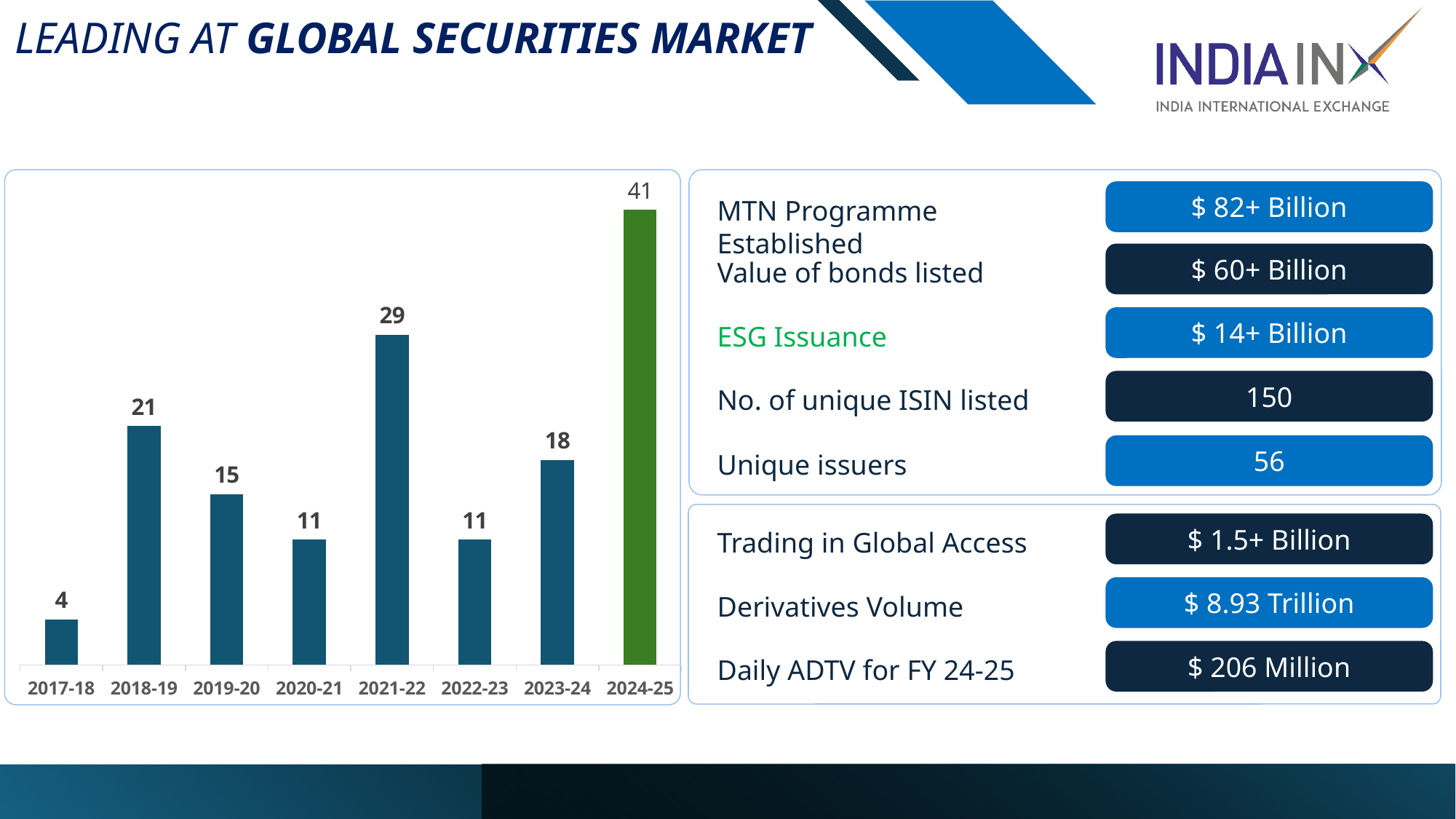
What kind of chart is shown on the slide? bar chart Which two years in the bar chart share the same value of 11? 2020-21 and 2022-23 What is the value for 2017-18 in the bar chart? 4 What is the difference between the values for 2021-22 and 2020-21? 18 Which bar in the chart is coloured green rather than dark blue? 2024-25 Which is larger, the value for 2018-19 or the value for 2019-20? 2018-19 What is the difference between the values for 2024-25 and 2023-24? 23 How many years are shown in the bar chart? 8 What is the value for 2024-25 in the bar chart? 41 What is the value for 2021-22 in the bar chart? 29 Which year has the lowest value in the bar chart? 2017-18 Which year has the highest value in the bar chart? 2024-25